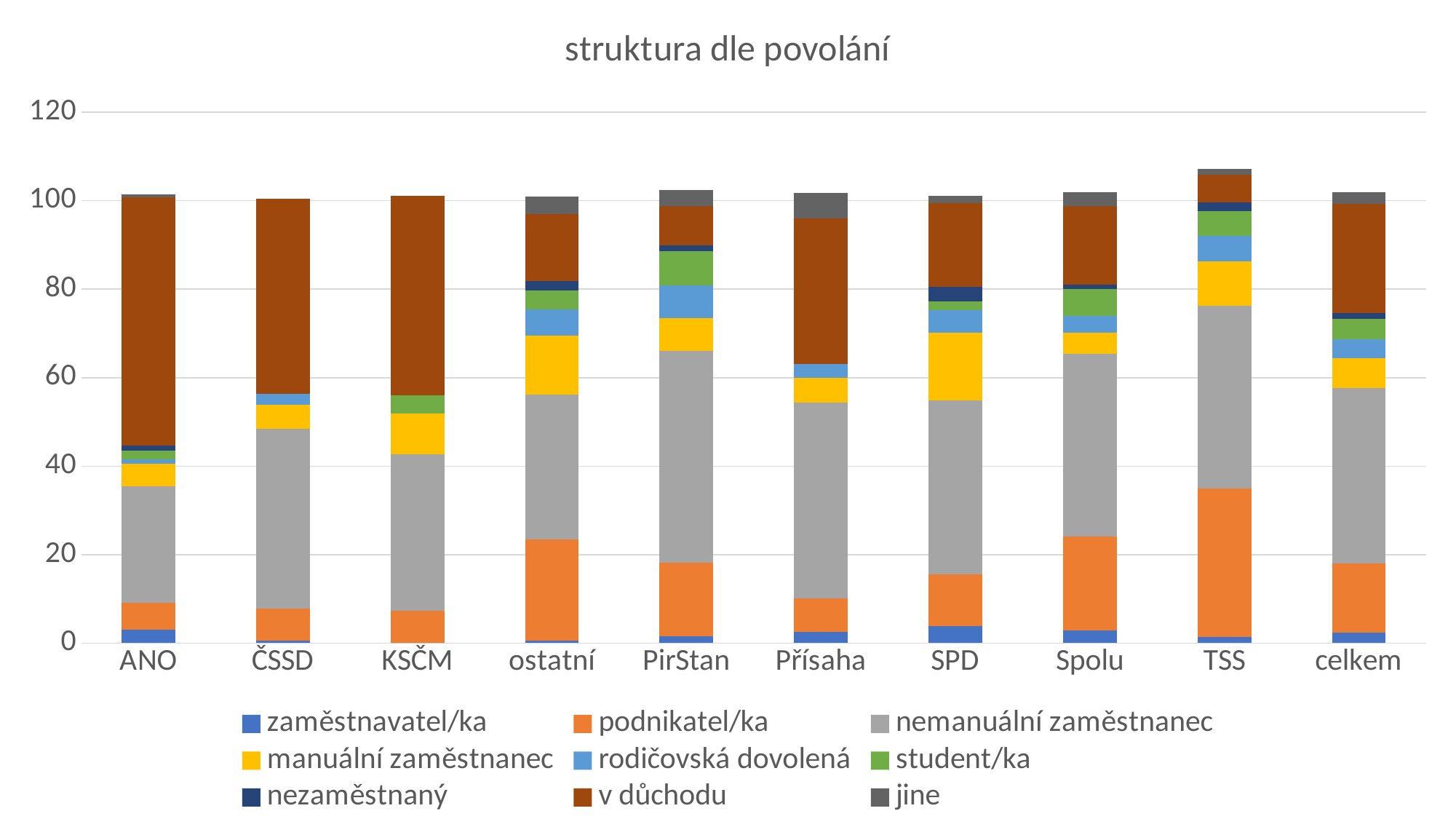
Which category has the larger podnikatel/ka segment, TSS or ANO? TSS Is the v důchodu segment for TSS greater or less than 20? less What is the title of the chart? struktura dle povolání What kind of chart is shown on the slide? Stacked bar chart Which category has the larger v důchodu segment, ANO or PirStan? ANO Is the total height of the stacked bar for TSS greater or less than 100? greater How many series does the legend list? 9 How many categories are shown along the x axis? 10 Which legend entry is shown in grey (the largest segment in most bars)? nemanuální zaměstnanec Is the podnikatel/ka segment for TSS greater or less than 20? greater Which category has the tallest stacked bar? TSS